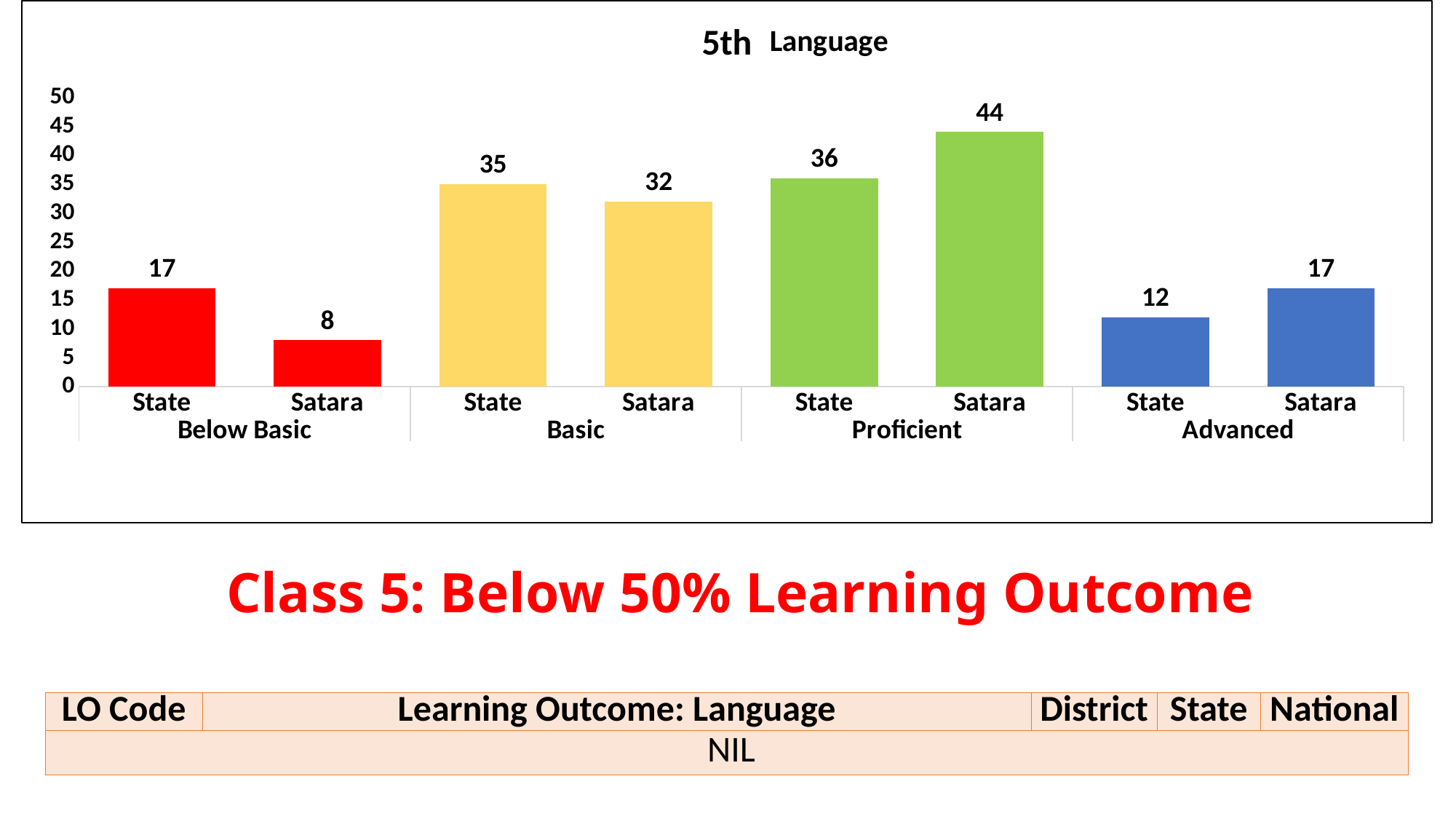
What kind of chart is shown on the slide? Bar chart What is the value for Satara in the Proficient group? 44 How many bars are plotted on the chart? 8 What is the difference between the State and Satara values in the Proficient group? 8 What is the value for State in the Basic group? 35 In the Basic group, which is larger, State or Satara? State Which bar has the highest value on the chart? Satara, Proficient Which bar has the lowest value on the chart? Satara, Below Basic What is the title of the chart? 5th Language What is the value for State in the Below Basic group? 17 What is the value for Satara in the Advanced group? 17 What is the difference between the State and Satara values in the Below Basic group? 9